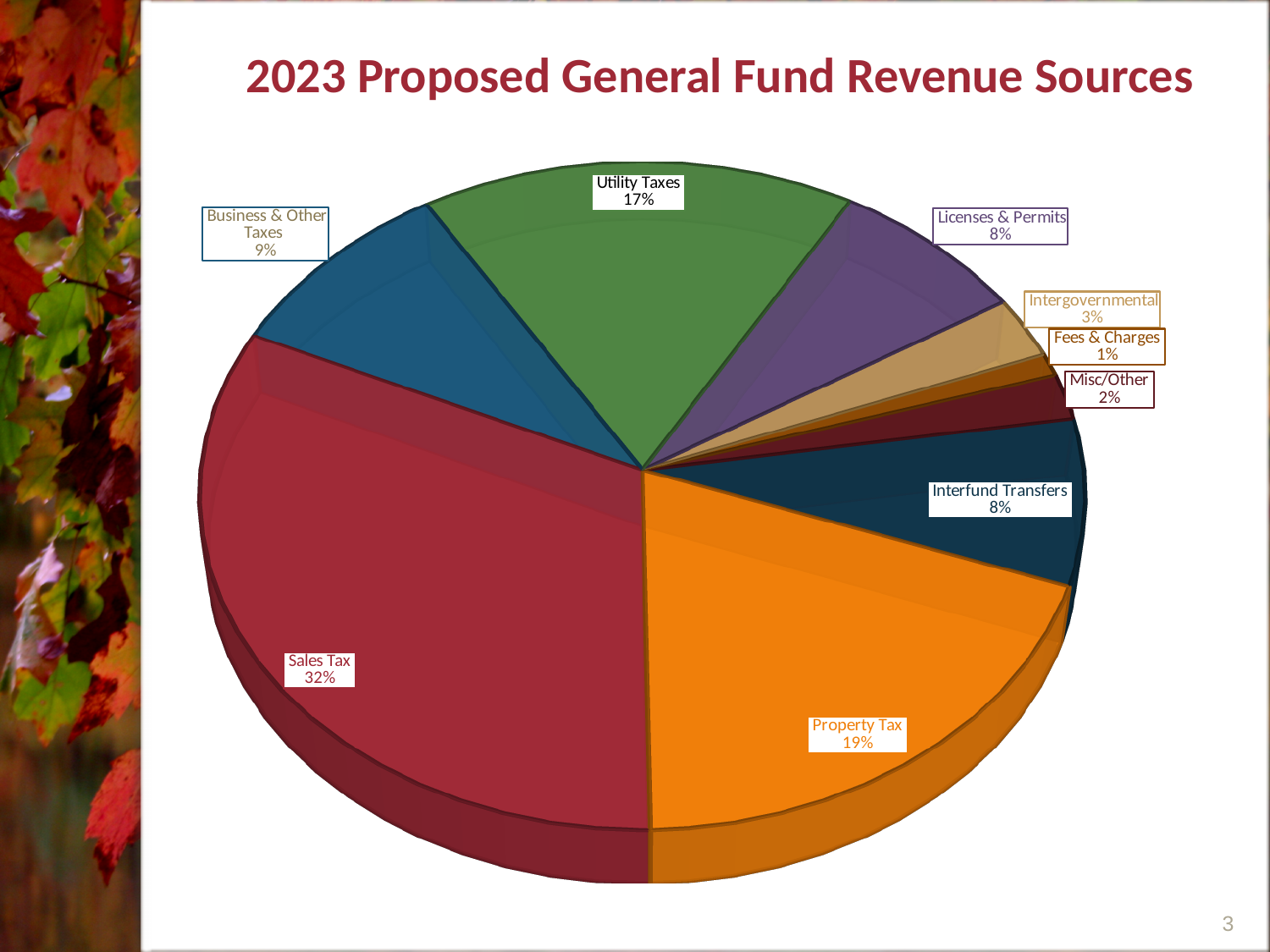
What is the title of the chart? 2023 Proposed General Fund Revenue Sources What share of revenue does Sales Tax represent? 32% What percentage is shown for Business & Other Taxes? 9% What percentage is shown for Property Tax? 19% Which revenue source has the smallest share of the pie? Fees & Charges What share is shown for Intergovernmental? 3% How many percentage points larger is Sales Tax than Property Tax? 13 What kind of chart is shown on the slide? Pie chart What share is labelled for Utility Taxes? 17% Which revenue source has the largest share of the pie? Sales Tax Which is larger, Utility Taxes or Business & Other Taxes? Utility Taxes How many slices does the pie chart have? 9